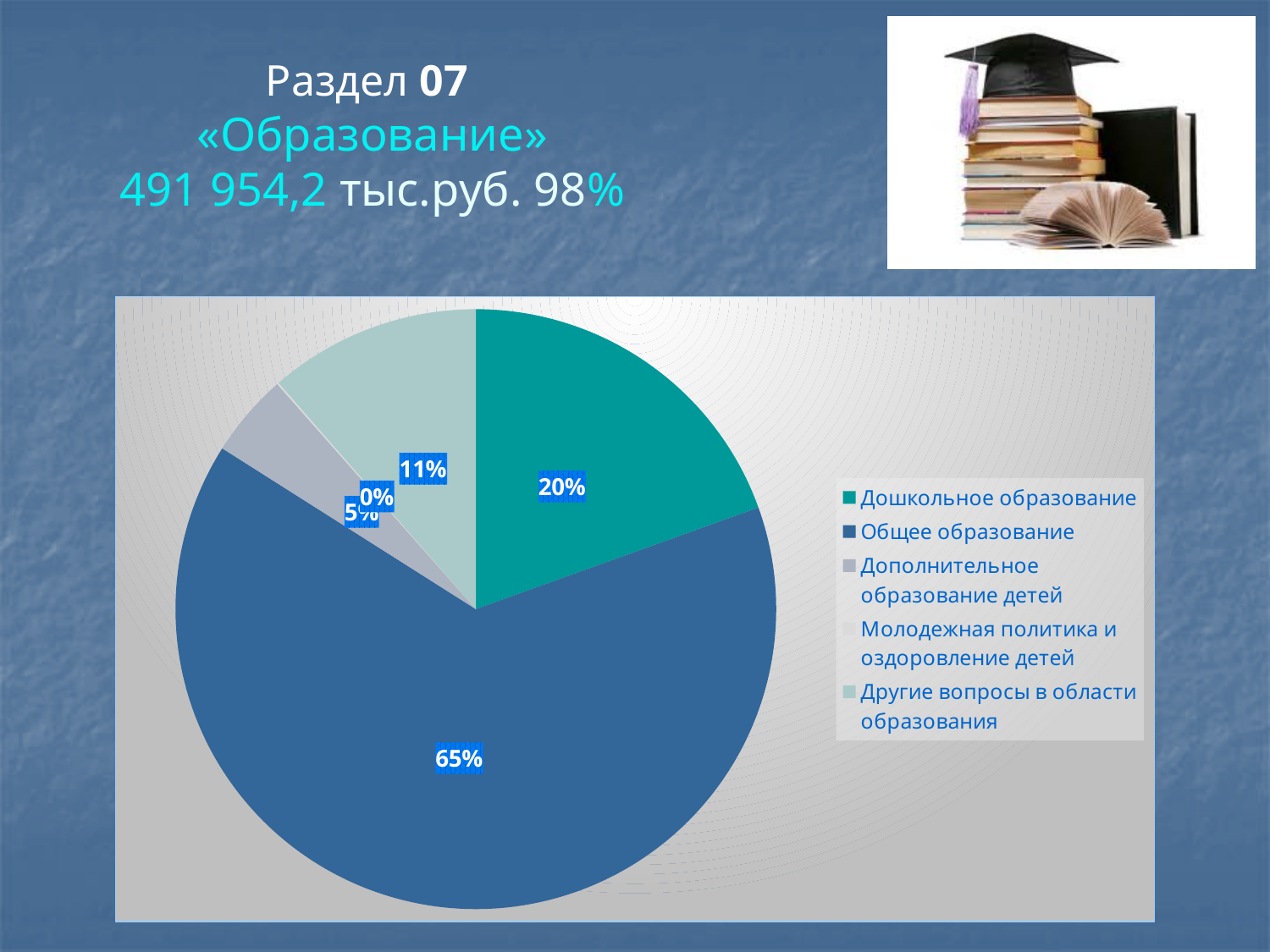
What is the difference in percentage points between Дошкольное образование and Другие вопросы в области образования? 9 What share of the pie does Молодежная политика и оздоровление детей have? 0% What share of the pie does Дошкольное образование have? 20% Which category has the largest slice of the pie? Общее образование What kind of chart is shown on the slide? pie chart What share of the pie does Общее образование have? 65% Which category has the smallest slice of the pie? Молодежная политика и оздоровление детей How many categories does the legend of the pie chart list? 5 Which slice is larger: Дошкольное образование or Другие вопросы в области образования? Дошкольное образование What is the difference in percentage points between Общее образование and Дошкольное образование? 45 Which legend entry is shown in the darkest blue colour? Общее образование